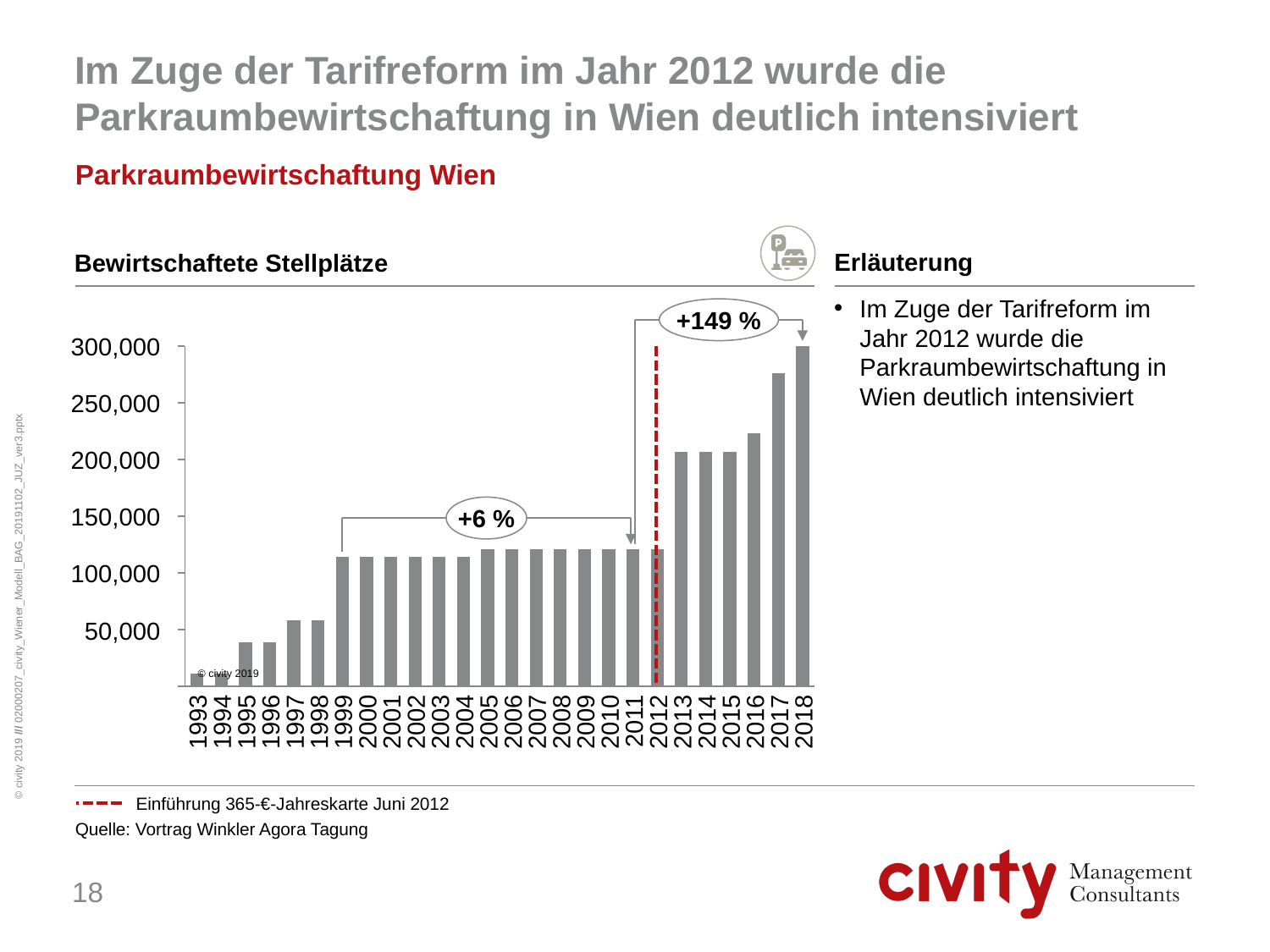
Do the values generally rise or fall from 1993 to 2018? rise Is the value for 2017 greater or less than 250,000? greater Is the value for 1995 greater or less than 50,000? less What does the red dashed vertical line in the chart mark? Einführung 365-€-Jahreskarte Juni 2012 Is the value for 2011 greater or less than 150,000? less Which year has the highest number of bewirtschaftete Stellplätze? 2018 How many years are shown on the x axis of the chart? 26 Which year has the larger value, 2016 or 2012? 2016 What kind of chart is shown under "Bewirtschaftete Stellplätze"? bar chart What percentage change is annotated between 2012 and 2018 on the chart? +149 %